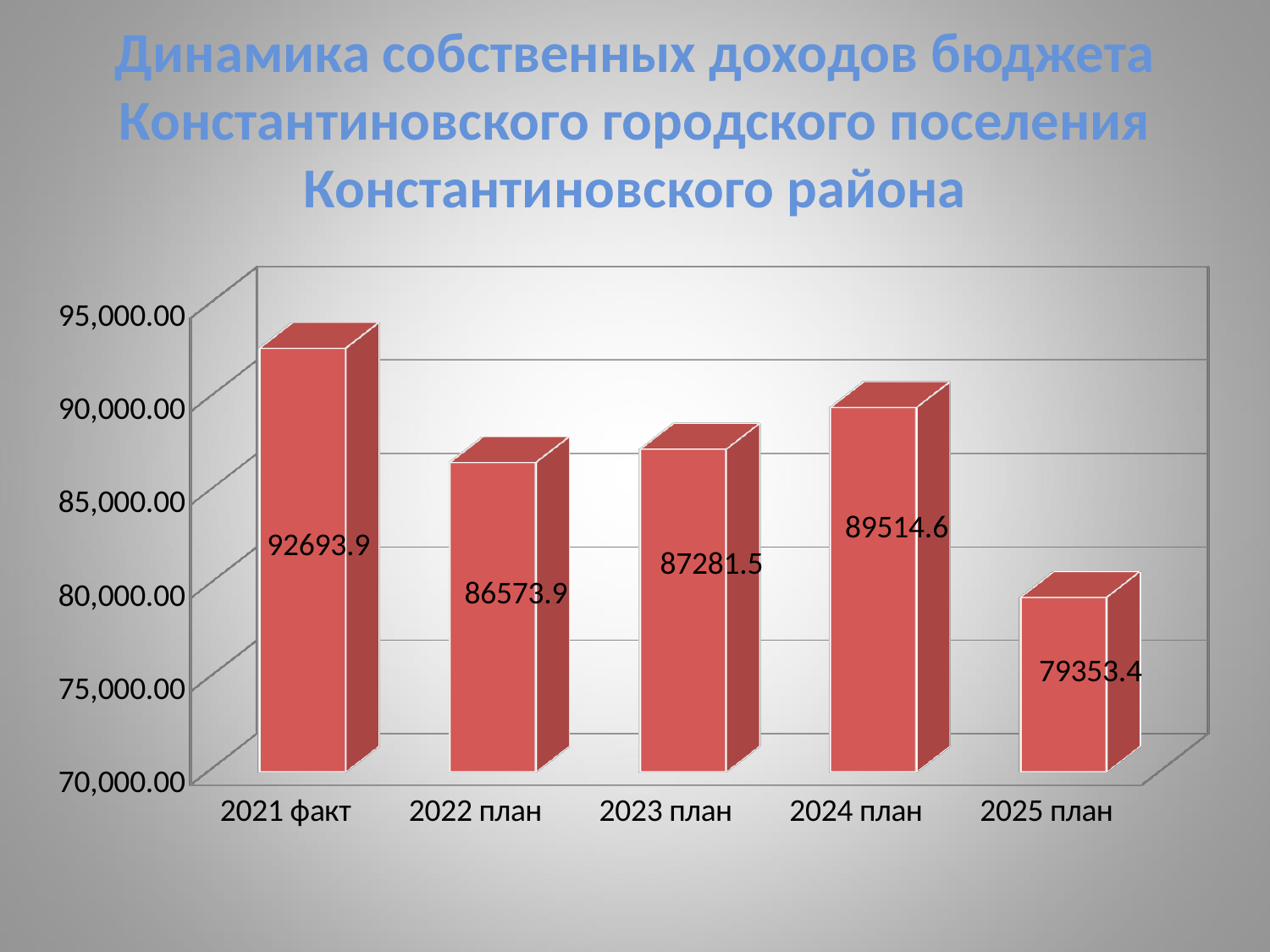
What is the value for 2025 план? 79353.4 How many categories are shown on the x axis? 5 Which category has the lowest value? 2025 план Is the value for 2025 план greater or less than 80,000.00? less Which is larger, the value for 2024 план or the value for 2022 план? 2024 план What is the difference between the values for 2021 факт and 2022 план? 6120.0 From 2022 план to 2024 план, do the values rise or fall? rise What kind of chart is shown on the slide? bar chart What is the value for 2023 план? 87281.5 What is the value for 2021 факт? 92693.9 What is the difference between the values for 2024 план and 2025 план? 10161.2 Which category has the highest value? 2021 факт